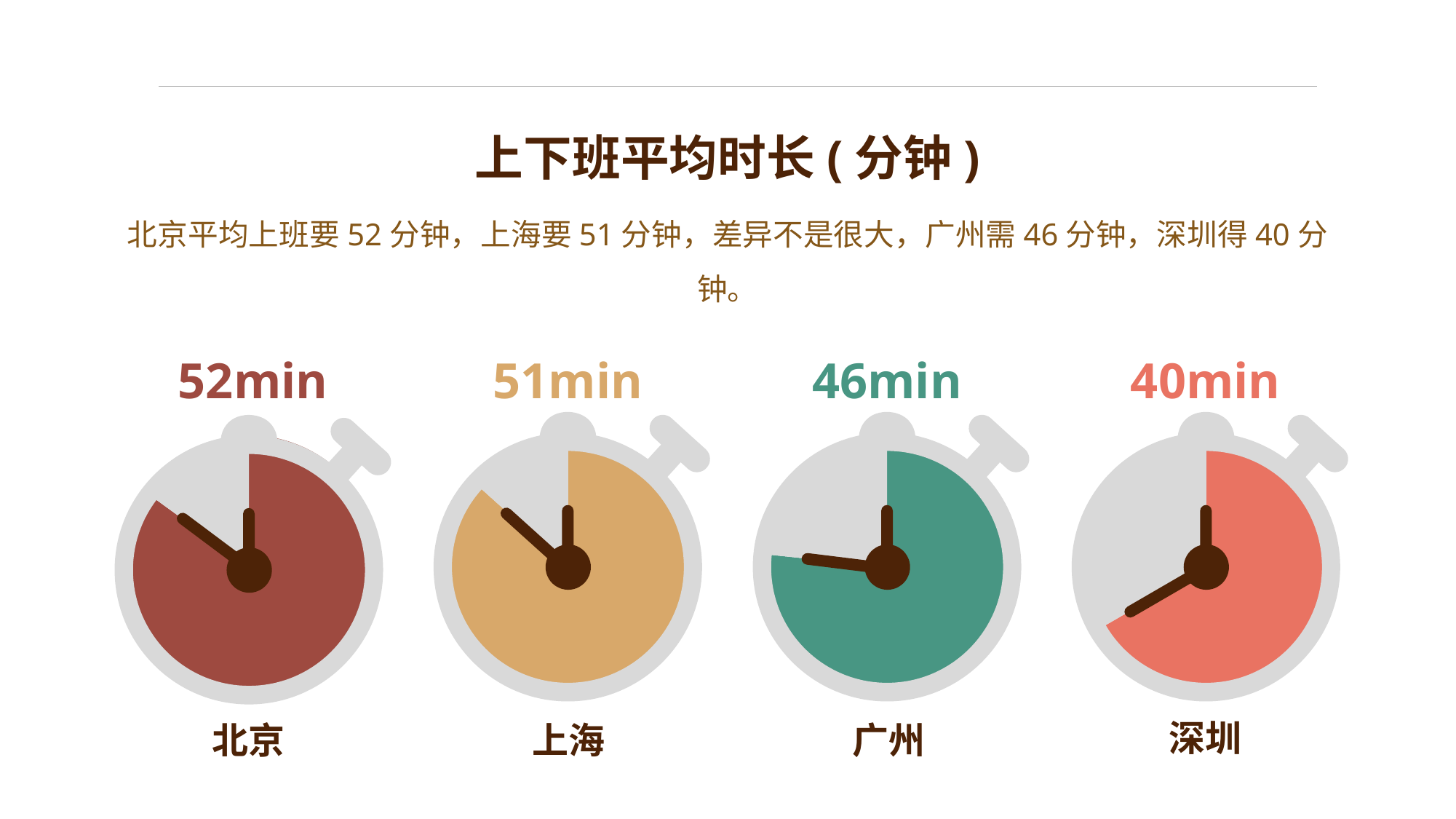
What is the average commute time shown for 上海? 51min Which city has the shortest average commute time? 深圳 What is the title of the chart? 上下班平均时长 ( 分钟 ) What is the average commute time shown for 广州? 46min Which city has a longer average commute time, 广州 or 深圳? 广州 What is the difference in average commute time between 上海 and 广州? 5min What is the difference in average commute time between 北京 and 深圳? 12min Which city has the longest average commute time? 北京 What colour is the gauge for 广州? Green What is the average commute time shown for 深圳? 40min How many cities are shown in the chart? 4 What is the average commute time shown for 北京? 52min